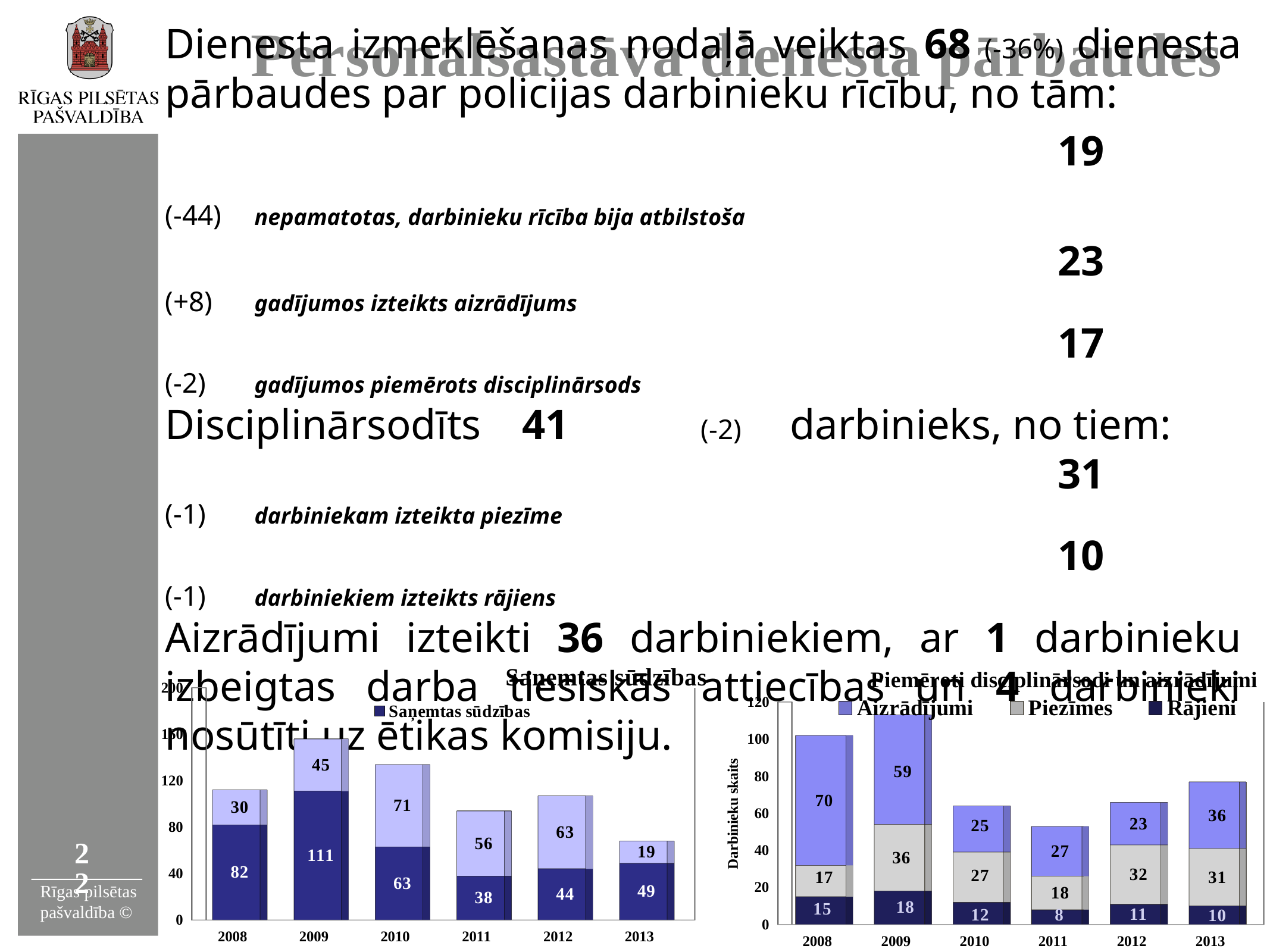
In the right chart (Piemēroti disciplinārsodi un aizrādījumi), what is the total of the stacked bar for 2013? 77 In the right chart (Piemēroti disciplinārsodi un aizrādījumi), what is the value for Rājieni in 2011? 8 In the right chart (Piemēroti disciplinārsodi un aizrādījumi), what is the value for Piezīmes in 2012? 32 In the left chart (Saņemtas sūdzības), what is the value of the dark blue segment for 2009? 111 How many series does the legend of the right chart (Piemēroti disciplinārsodi un aizrādījumi) list? 3 In the right chart (Piemēroti disciplinārsodi un aizrādījumi), what is the difference between Aizrādījumi in 2008 and in 2009? 11 In the right chart (Piemēroti disciplinārsodi un aizrādījumi), which year has the highest value for Rājieni? 2009 In the right chart (Piemēroti disciplinārsodi un aizrādījumi), what is the value for Aizrādījumi in 2008? 70 In the left chart (Saņemtas sūdzības), what is the total of the stacked bar for 2013? 68 What type of chart is the left chart (Saņemtas sūdzības)? Stacked bar chart In the right chart (Piemēroti disciplinārsodi un aizrādījumi), which year has the lowest value for Piezīmes? 2008 How many years are shown on the x axis of the left chart (Saņemtas sūdzības)? 6